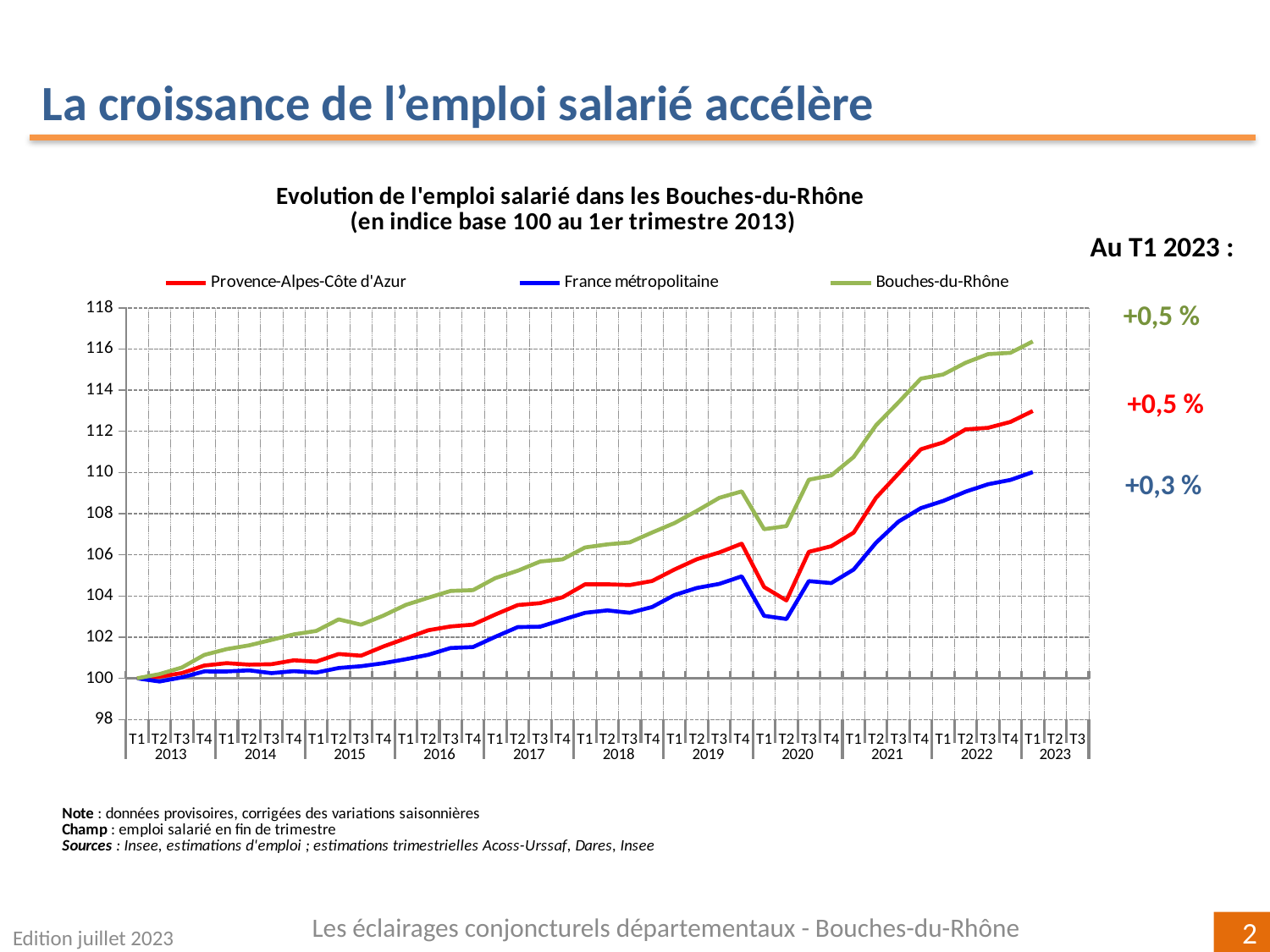
Is the value for Bouches-du-Rhône at T1 2023 greater or less than 114? greater Overall, do the values for Provence-Alpes-Côte d'Azur rise or fall from 2013 to 2023? rise What growth rate is annotated for France métropolitaine at T1 2023? +0,3 % Which series has the highest value at T1 2023? Bouches-du-Rhône What is the title of the chart? Evolution de l'emploi salarié dans les Bouches-du-Rhône (en indice base 100 au 1er trimestre 2013) Is the value for Bouches-du-Rhône at T2 2020 greater or less than 108? less How many series does the legend list? 3 Which series has the lowest value at T1 2023? France métropolitaine How many years are labelled on the x axis? 11 What kind of chart is shown on the slide? line chart What growth rate is annotated for Bouches-du-Rhône at T1 2023? +0,5 % Which series is shown in green in the legend? Bouches-du-Rhône